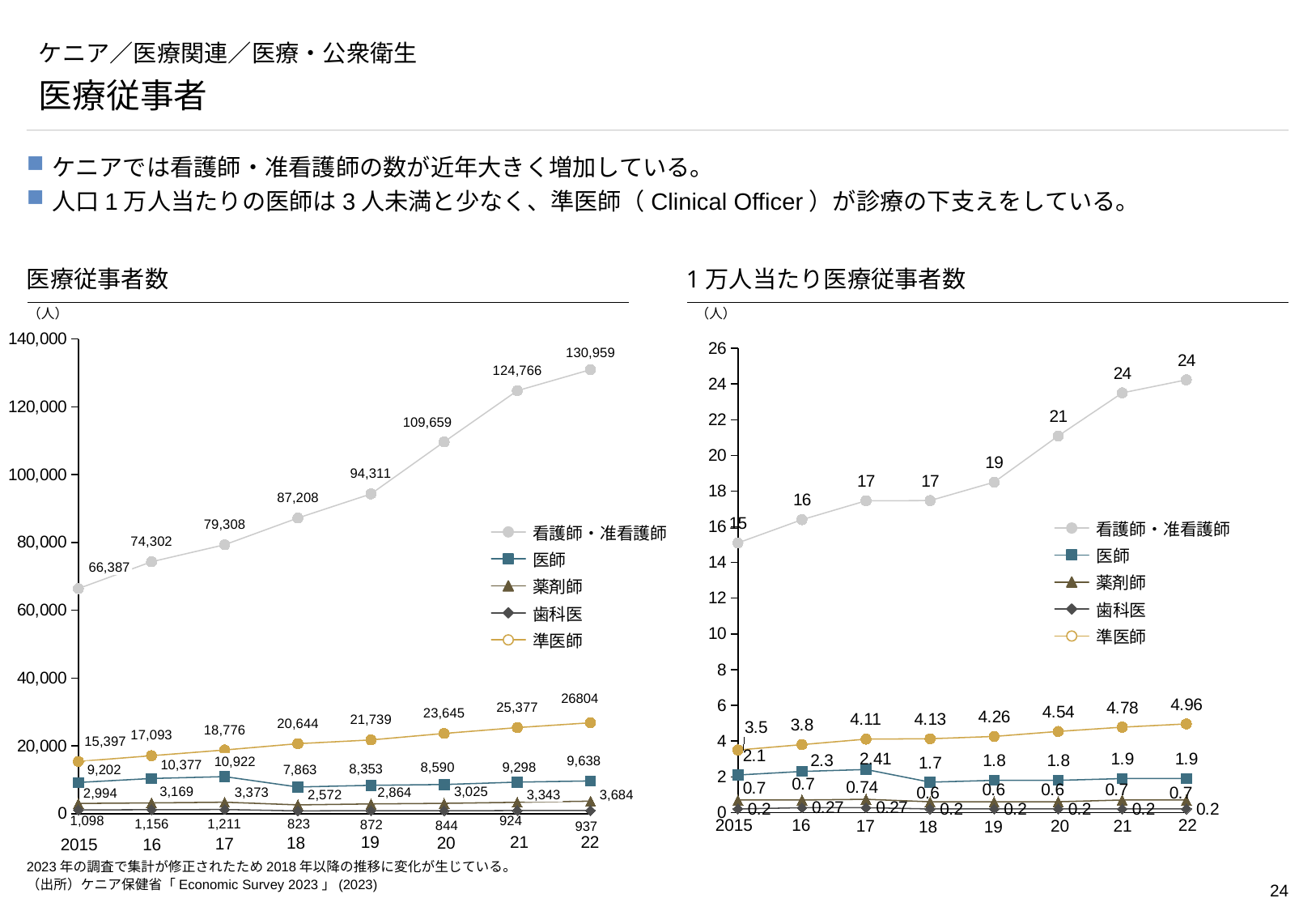
In the 医療従事者数 chart on the left, what is the value for 看護師・准看護師 in 2022? 130,959 In the 1万人当たり医療従事者数 chart on the right, in which year is the 歯科医 value lowest among 2015, 2016 and 2017? 2015 In the 1万人当たり医療従事者数 chart on the right, what is the value for 準医師 in 2022? 4.96 In the 医療従事者数 chart on the left, what is the value for 準医師 in 2015? 15,397 In the 医療従事者数 chart on the left, what is the difference between the 看護師・准看護師 values in 2022 and 2021? 6,193 In the 1万人当たり医療従事者数 chart on the right, does the 看護師・准看護師 value generally rise or fall from 2015 to 2022? Rise In the 医療従事者数 chart on the left, how many series does the legend list? 5 In the 1万人当たり医療従事者数 chart on the right, what is the value for 医師 in 2017? 2.41 What kind of chart is the 医療従事者数 chart on the left? Line chart In the 医療従事者数 chart on the left, in which year is the 看護師・准看護師 value highest? 2022 In the 1万人当たり医療従事者数 chart on the right, how many years are plotted on the x axis? 8 In the 医療従事者数 chart on the left, what is the value for 医師 in 2018? 7,863